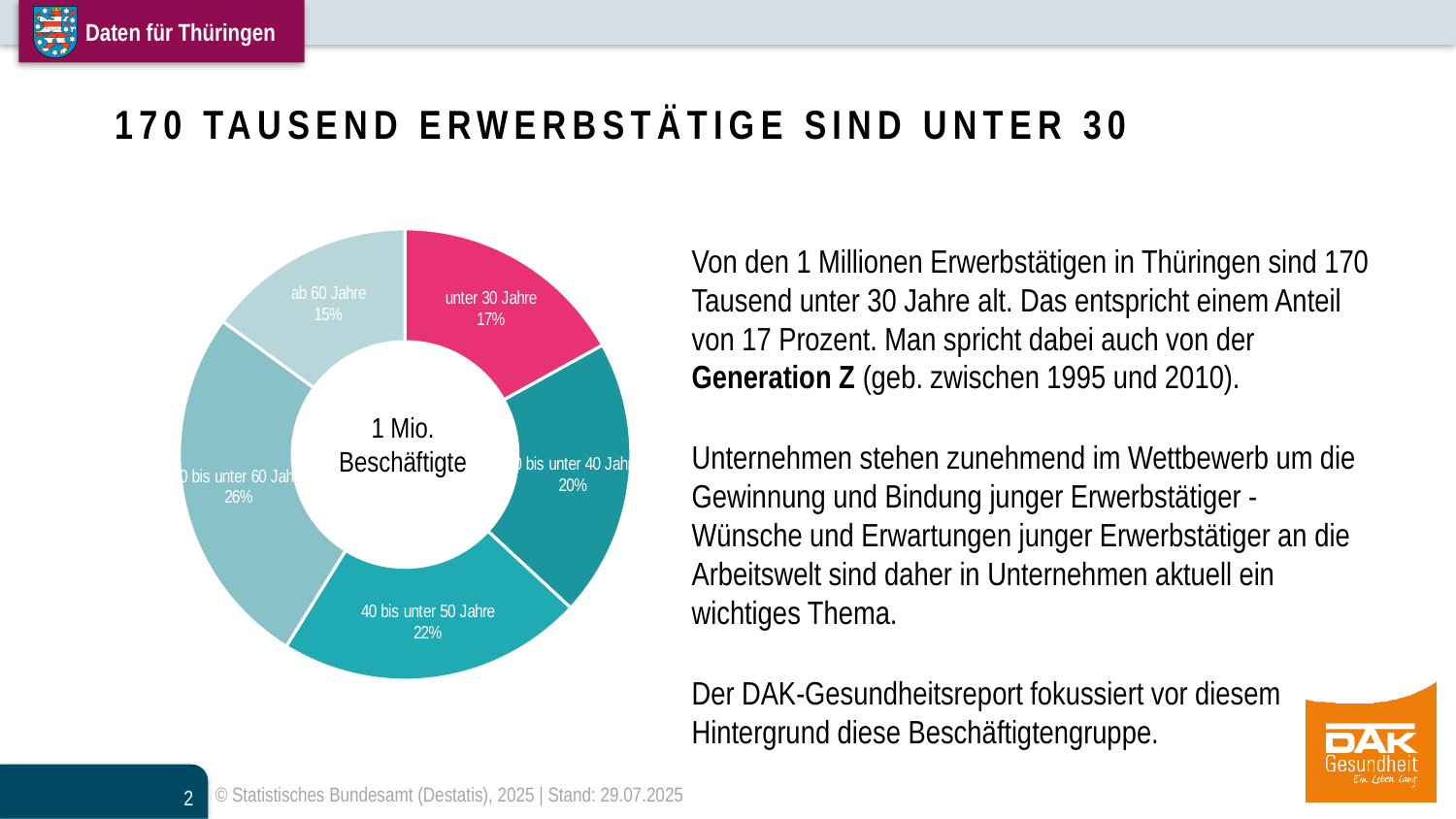
What kind of chart is shown on the slide? pie chart (donut) How many slices does the chart have? 5 Which slice of the chart has the smallest share? ab 60 Jahre What colour is the slice for 'unter 30 Jahre'? pink (magenta) What text is written in the centre of the donut chart? 1 Mio. Beschäftigte What percentage is shown for the slice 'ab 60 Jahre'? 15% What is the combined share of the slices 'unter 30 Jahre' and 'ab 60 Jahre'? 32% By how many percentage points is the share of '40 bis unter 50 Jahre' larger than that of 'unter 30 Jahre'? 5 percentage points Which slice is larger, 'unter 30 Jahre' or 'ab 60 Jahre'? unter 30 Jahre What percentage is shown for the slice '40 bis unter 50 Jahre'? 22% What is the largest percentage shown on any slice of the chart? 26% What percentage is shown for the slice 'unter 30 Jahre'? 17%